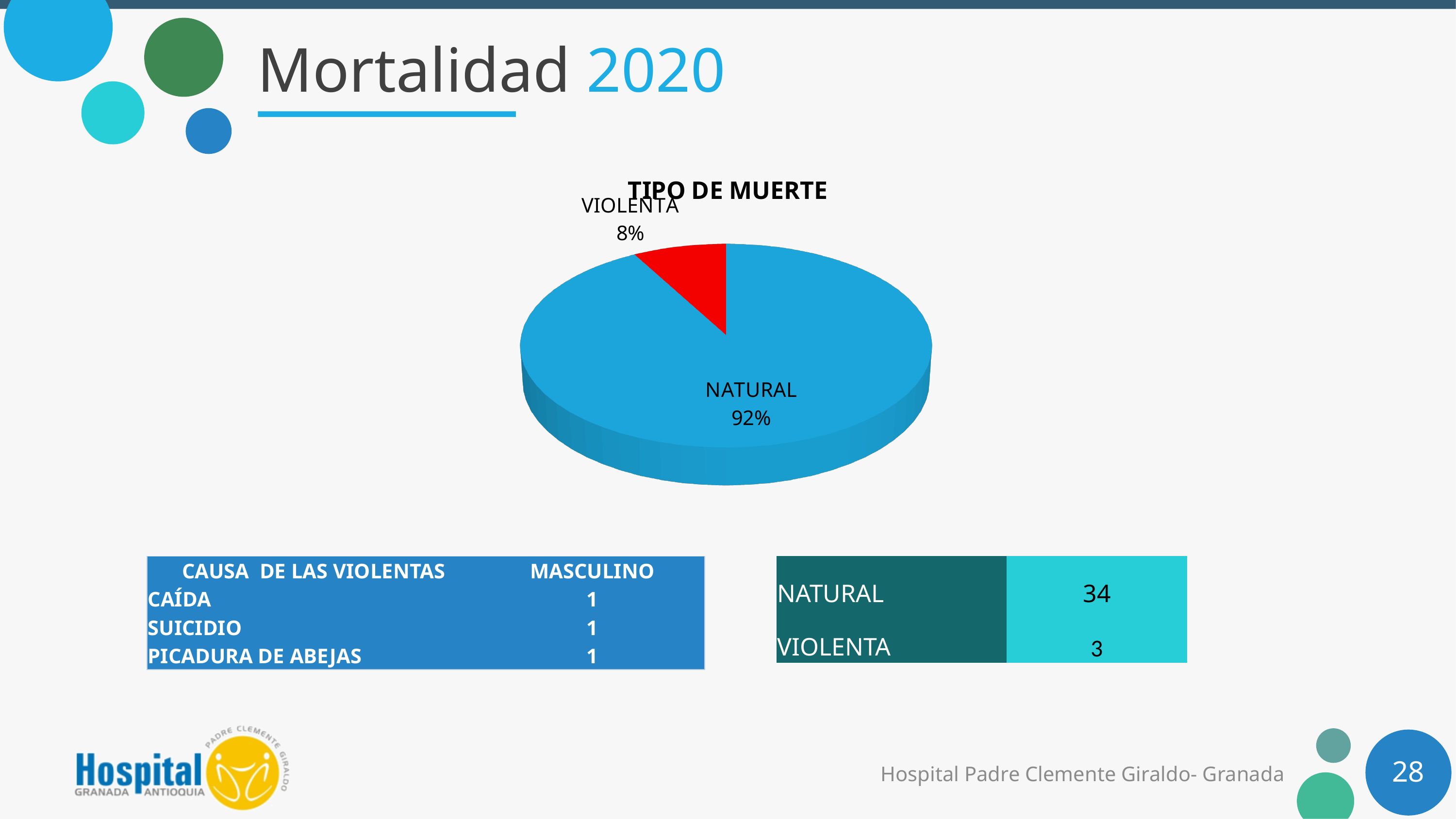
How many slices does the pie chart have? 2 What is the title of the pie chart? TIPO DE MUERTE What type of chart is shown under the title TIPO DE MUERTE? pie chart What share of the pie does the VIOLENTA slice represent? 8% What percentage of the pie chart is labelled NATURAL? 92% Which slice of the pie chart is the smallest? VIOLENTA Which slice of the pie chart is the largest? NATURAL What percentage of the pie chart is labelled VIOLENTA? 8% What is the difference in percentage points between the NATURAL and VIOLENTA slices? 84 What colour is the VIOLENTA slice of the pie chart? red Which slice is larger, NATURAL or VIOLENTA? NATURAL